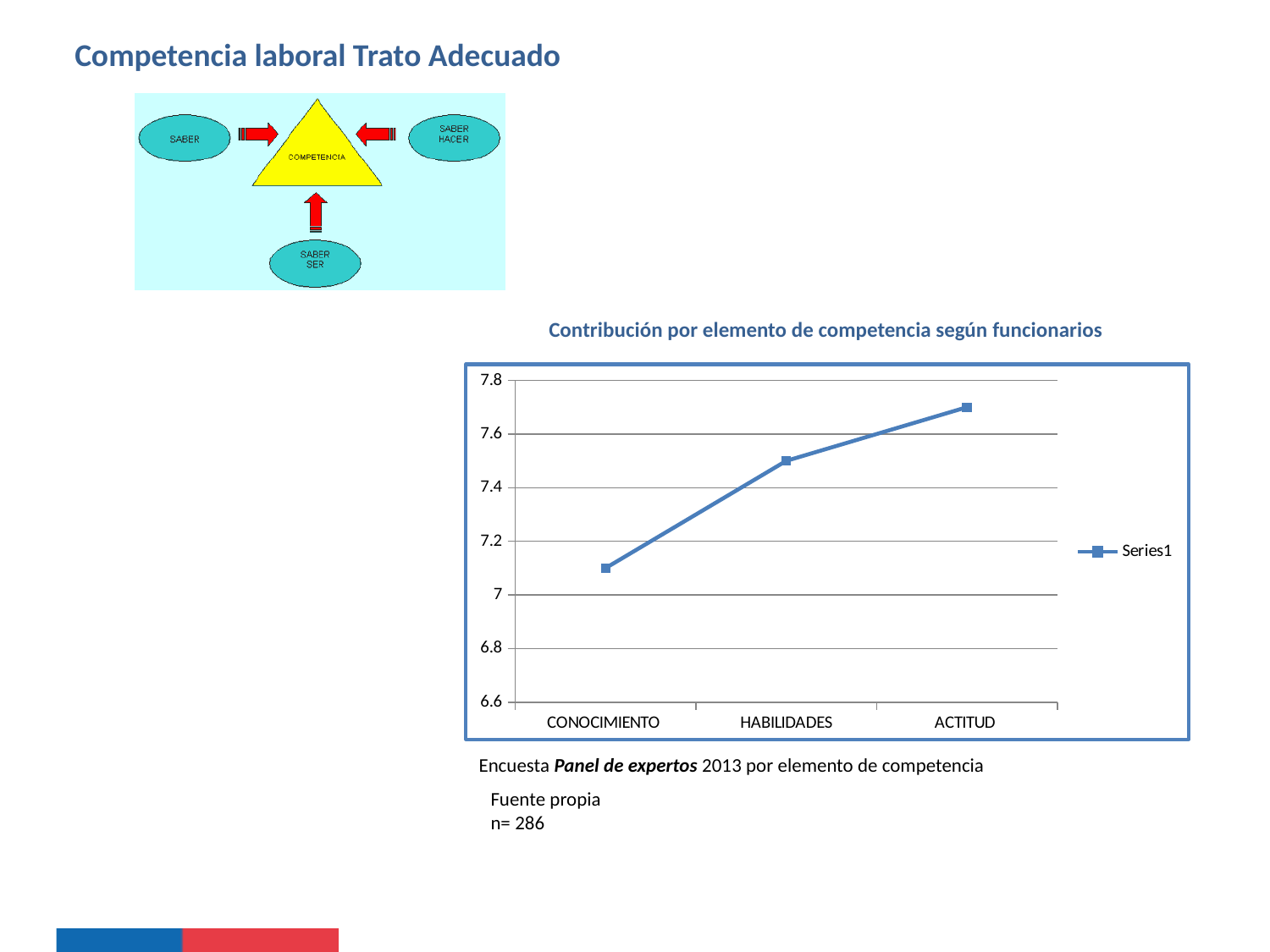
Is the value for CONOCIMIENTO greater or less than 7.2? less How many categories are plotted on the x axis of the chart? 3 Do the values rise or fall from CONOCIMIENTO to ACTITUD along the x axis? rise What kind of chart is shown on the slide? line chart Which category has the highest value in the chart? ACTITUD Is the value for ACTITUD greater or less than 7.6? greater Which is larger, the value for HABILIDADES or the value for CONOCIMIENTO? HABILIDADES Which category has the lowest value in the chart? CONOCIMIENTO How many series does the chart legend list? 1 What is the title of the chart? Contribución por elemento de competencia según funcionarios Is the value for HABILIDADES greater or less than 7.4? greater What is the name of the series shown in the chart legend? Series1